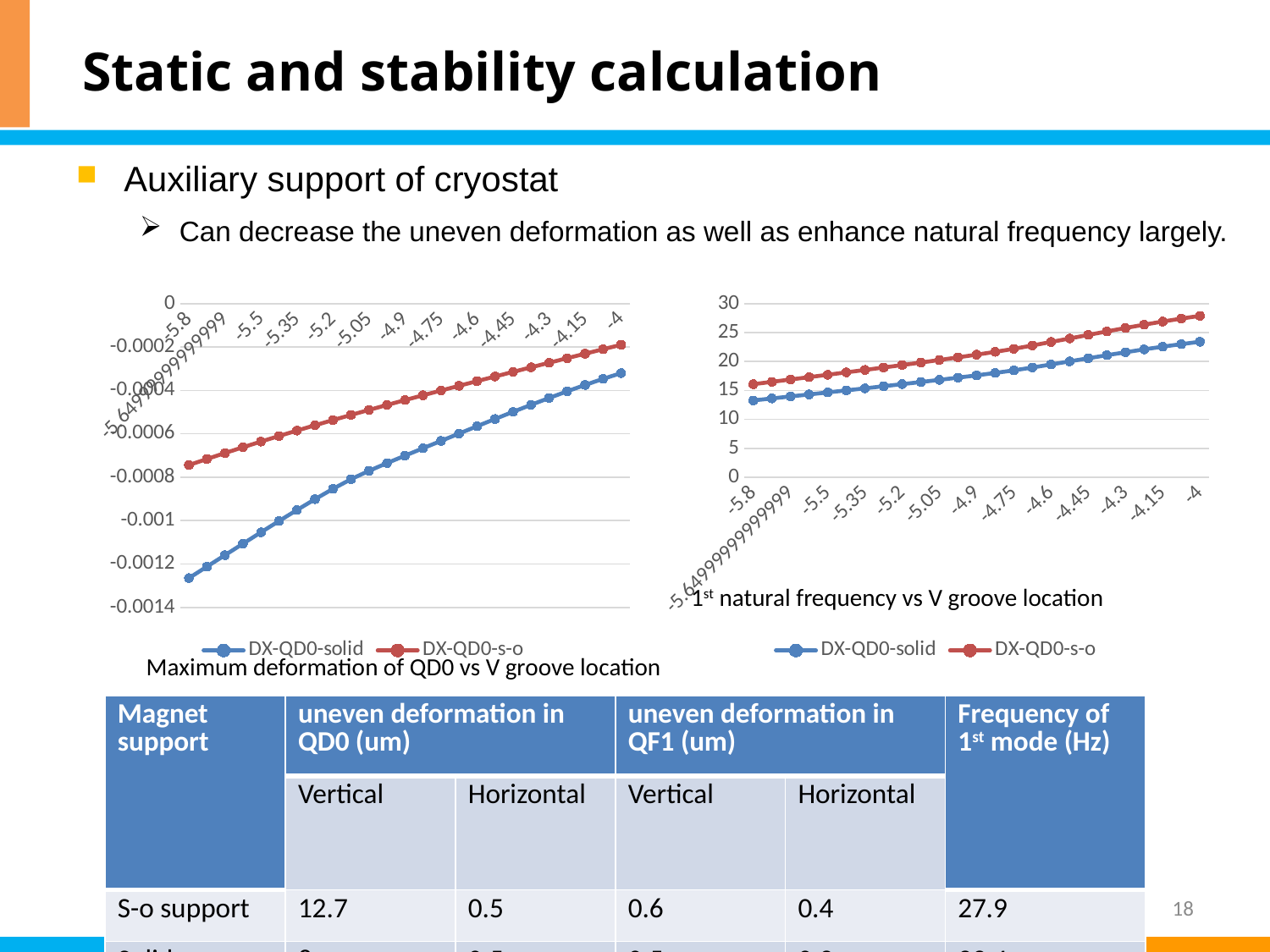
In the 'Maximum deformation of QD0 vs V groove location' chart, do the values of DX-QD0-solid rise or fall along the x axis from -5.8 to -4? rise In the 'Maximum deformation of QD0 vs V groove location' chart, which series is plotted in red? DX-QD0-s-o How many series does the legend of the '1st natural frequency vs V groove location' chart list? 2 In the '1st natural frequency vs V groove location' chart, is the value for DX-QD0-s-o at -4 greater or less than 25? greater In the '1st natural frequency vs V groove location' chart, is the value for DX-QD0-solid at -4 greater or less than 20? greater What kind of chart is the 'Maximum deformation of QD0 vs V groove location' chart? line chart In the 'Maximum deformation of QD0 vs V groove location' chart, what are the two series named in the legend? DX-QD0-solid and DX-QD0-s-o In the '1st natural frequency vs V groove location' chart, which series has the higher values across the whole range, DX-QD0-solid or DX-QD0-s-o? DX-QD0-s-o In the '1st natural frequency vs V groove location' chart, is the value for DX-QD0-solid at -5.8 greater or less than 15? less What kind of chart is the '1st natural frequency vs V groove location' chart? line chart In the '1st natural frequency vs V groove location' chart, do the values of DX-QD0-s-o rise or fall as the V groove location goes from -5.8 to -4? rise